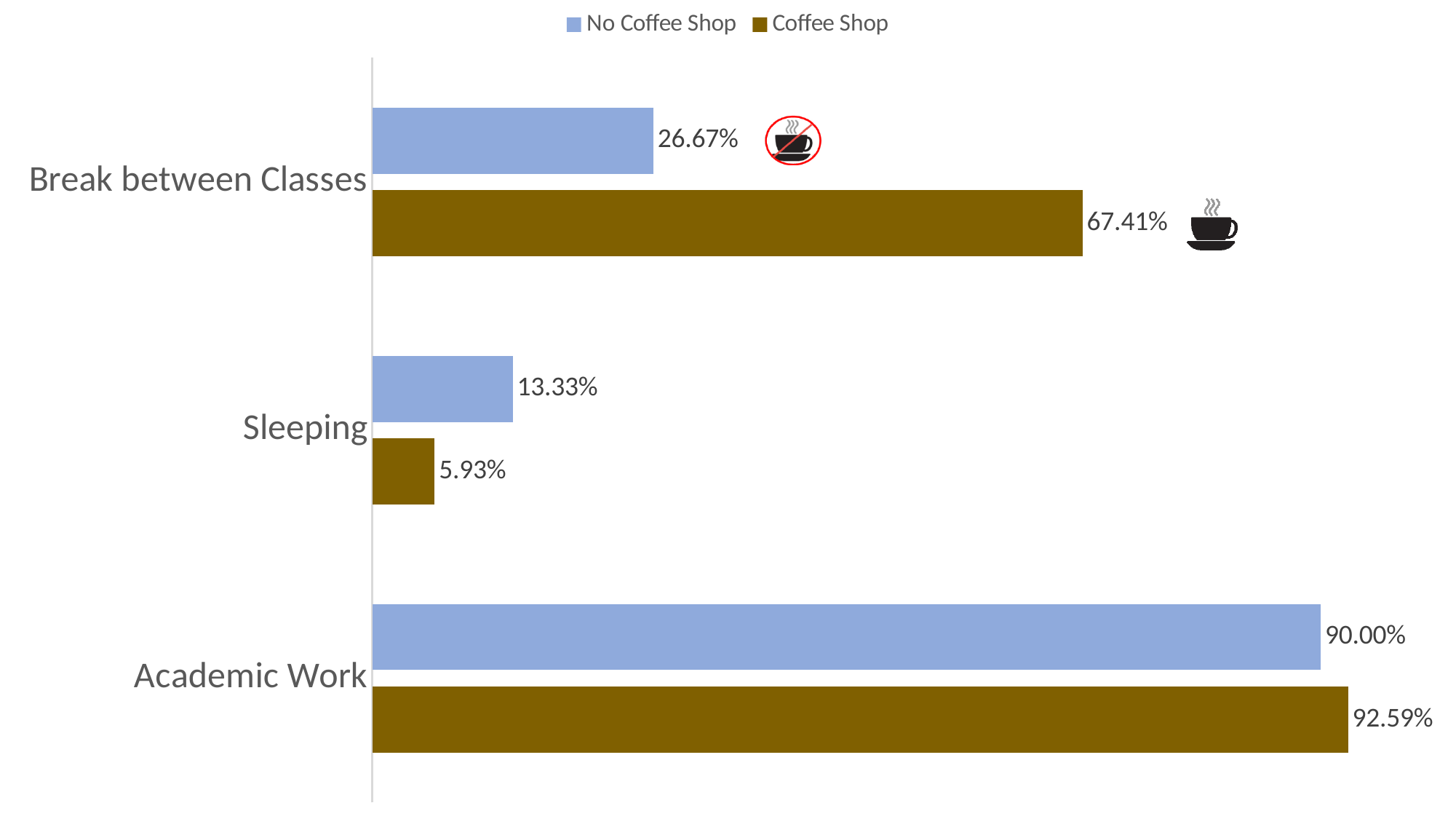
What is the value for No Coffee Shop in the Break between Classes category? 26.67% What is the value for Coffee Shop in the Break between Classes category? 67.41% Which is larger for Sleeping: the No Coffee Shop value or the Coffee Shop value? No Coffee Shop What is the difference between the Coffee Shop and No Coffee Shop values for Break between Classes? 40.74% What kind of chart is shown on the slide? Bar chart Which category has the highest value for the Coffee Shop series? Academic Work What is the value for Coffee Shop in the Academic Work category? 92.59% What is the value for No Coffee Shop in the Sleeping category? 13.33% How many series does the legend list? 2 What colour are the bars for the Coffee Shop series? Brown How many categories are shown on the chart? 3 Which category has the lowest value for the No Coffee Shop series? Sleeping